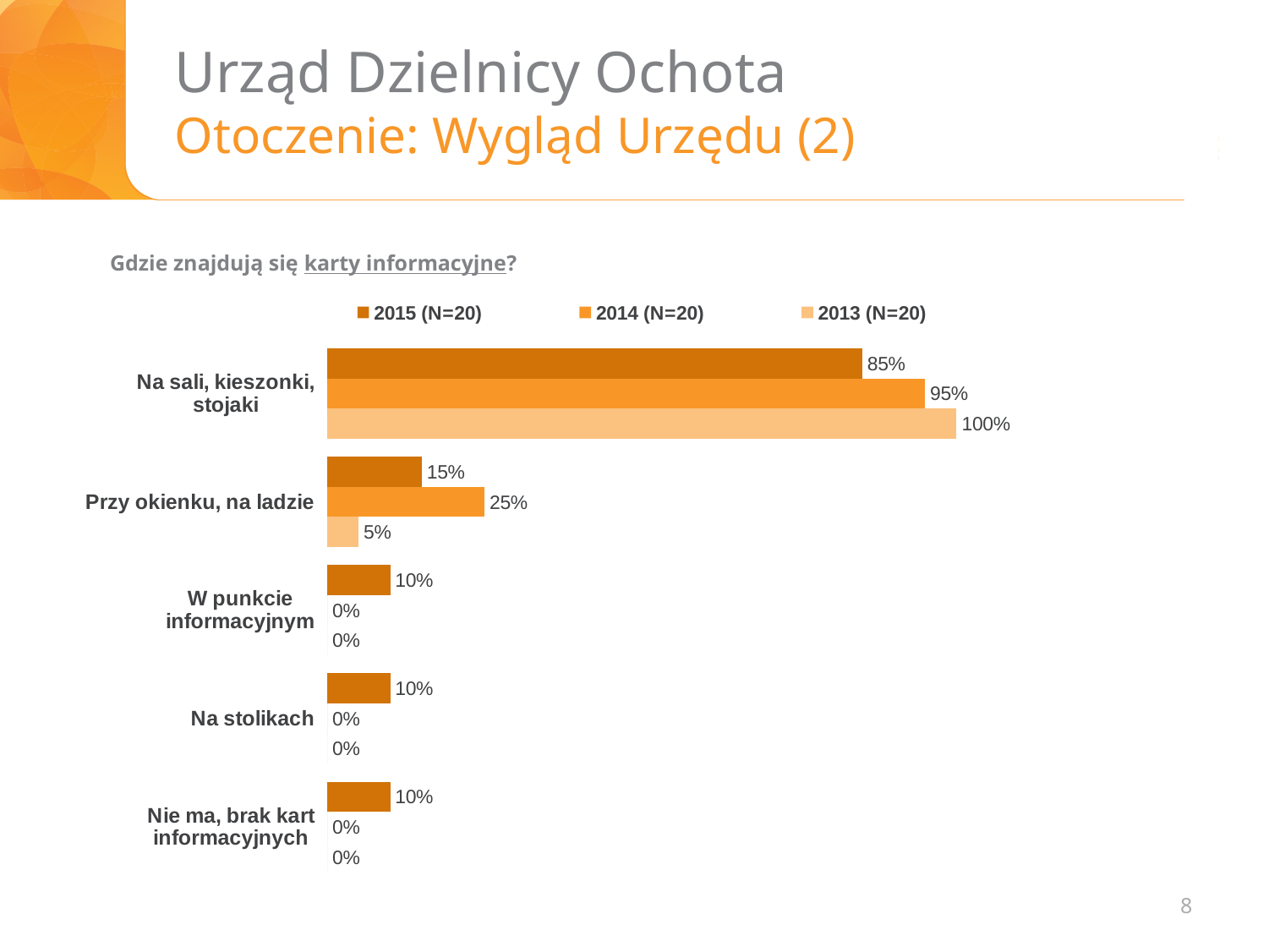
What is the difference between the 2013 (N=20) and 2015 (N=20) values for "Na sali, kieszonki, stojaki"? 15% What question does the chart answer, as stated above it? Gdzie znajdują się karty informacyjne? What is the value for "Na stolikach" in the 2015 (N=20) series? 10% What is the value for "Na sali, kieszonki, stojaki" in the 2015 (N=20) series? 85% What kind of chart is shown on the slide? Bar chart What is the value for "Przy okienku, na ladzie" in the 2013 (N=20) series? 5% What is the value for "Przy okienku, na ladzie" in the 2014 (N=20) series? 25% Which category has the highest value in the 2013 (N=20) series? Na sali, kieszonki, stojaki How many categories are shown on the chart? 5 How many series does the legend list? 3 Which is larger for "Przy okienku, na ladzie": the 2015 (N=20) value or the 2014 (N=20) value? 2014 (N=20)